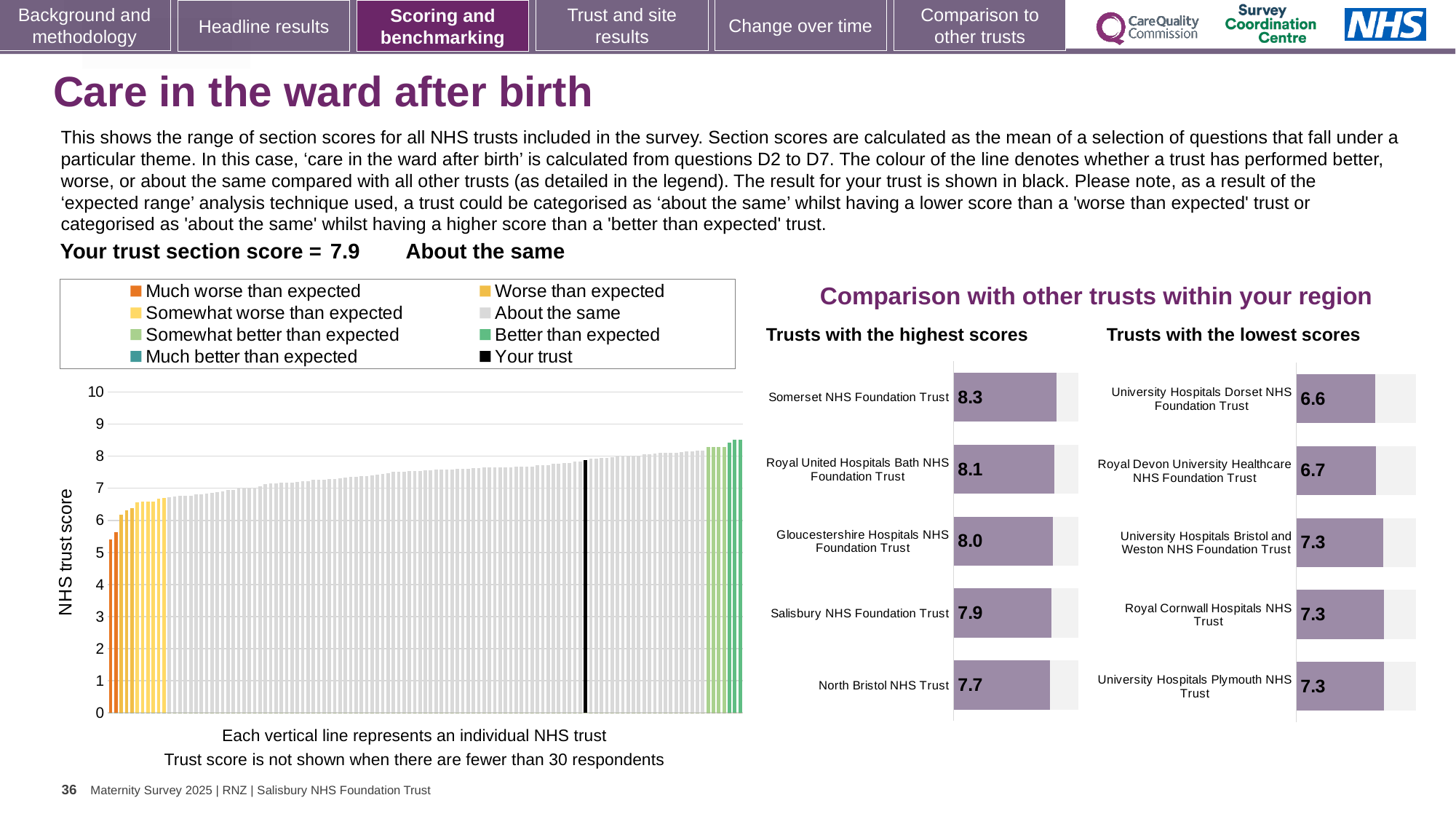
In the large chart on the left, what is the section score for 'Your trust' (the black bar)? 7.9 In the 'Trusts with the highest scores' chart, which trust has the lowest score shown? North Bristol NHS Trust In the 'Trusts with the highest scores' chart, how many trusts are shown? 5 In the large chart on the left, do the trust scores rise or fall from left to right? rise In the large chart on the left, is the value of the leftmost (lowest) bar greater or less than 6? less In the 'Trusts with the lowest scores' chart, what is the score for Royal Devon University Healthcare NHS Foundation Trust? 6.7 In the 'Trusts with the lowest scores' chart, which trust has the lowest score? University Hospitals Dorset NHS Foundation Trust In the 'Trusts with the lowest scores' chart, which has the larger score: University Hospitals Dorset NHS Foundation Trust or Royal Cornwall Hospitals NHS Trust? Royal Cornwall Hospitals NHS Trust In the 'Trusts with the highest scores' chart, what is the score for Somerset NHS Foundation Trust? 8.3 In the 'Trusts with the highest scores' chart, what is the difference between the scores of Somerset NHS Foundation Trust and North Bristol NHS Trust? 0.6 In the large chart on the left, how many entries does the legend list? 8 What kind of chart is the large chart on the left with the y axis labelled 'NHS trust score'? bar chart